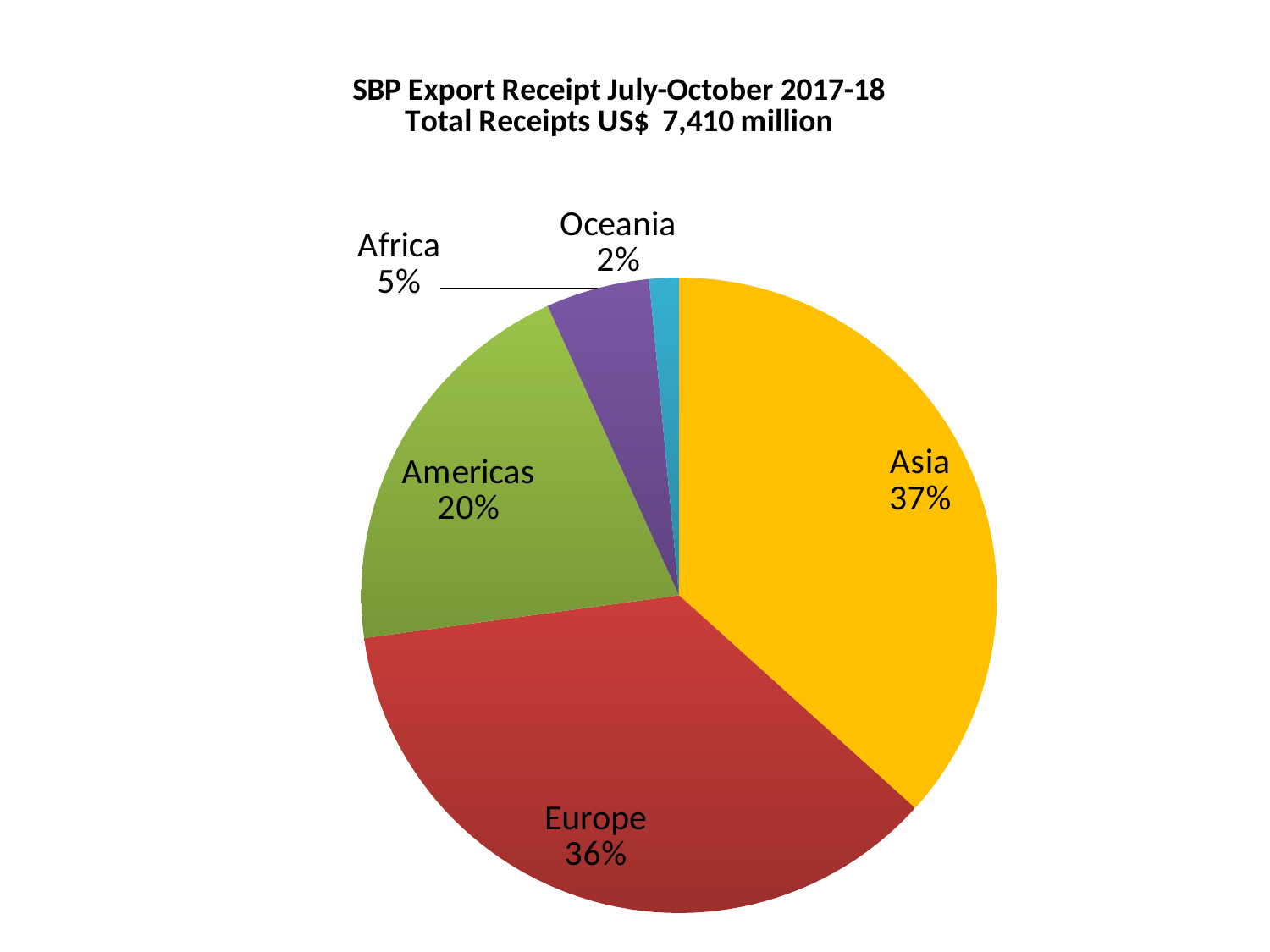
What kind of chart is shown on the slide? Pie chart How many regions are shown in the pie chart? 5 What share of SBP export receipts does Asia account for? 37% Which region has the smallest share of SBP export receipts? Oceania What is the difference in percentage points between the Americas' share and Africa's share? 15 Which region has the largest share of SBP export receipts? Asia What total receipts figure is stated in the chart title? US$ 7,410 million What share of SBP export receipts does Africa account for? 5% What share of SBP export receipts does the Americas account for? 20% Which has a larger share of SBP export receipts, the Americas or Africa? Americas